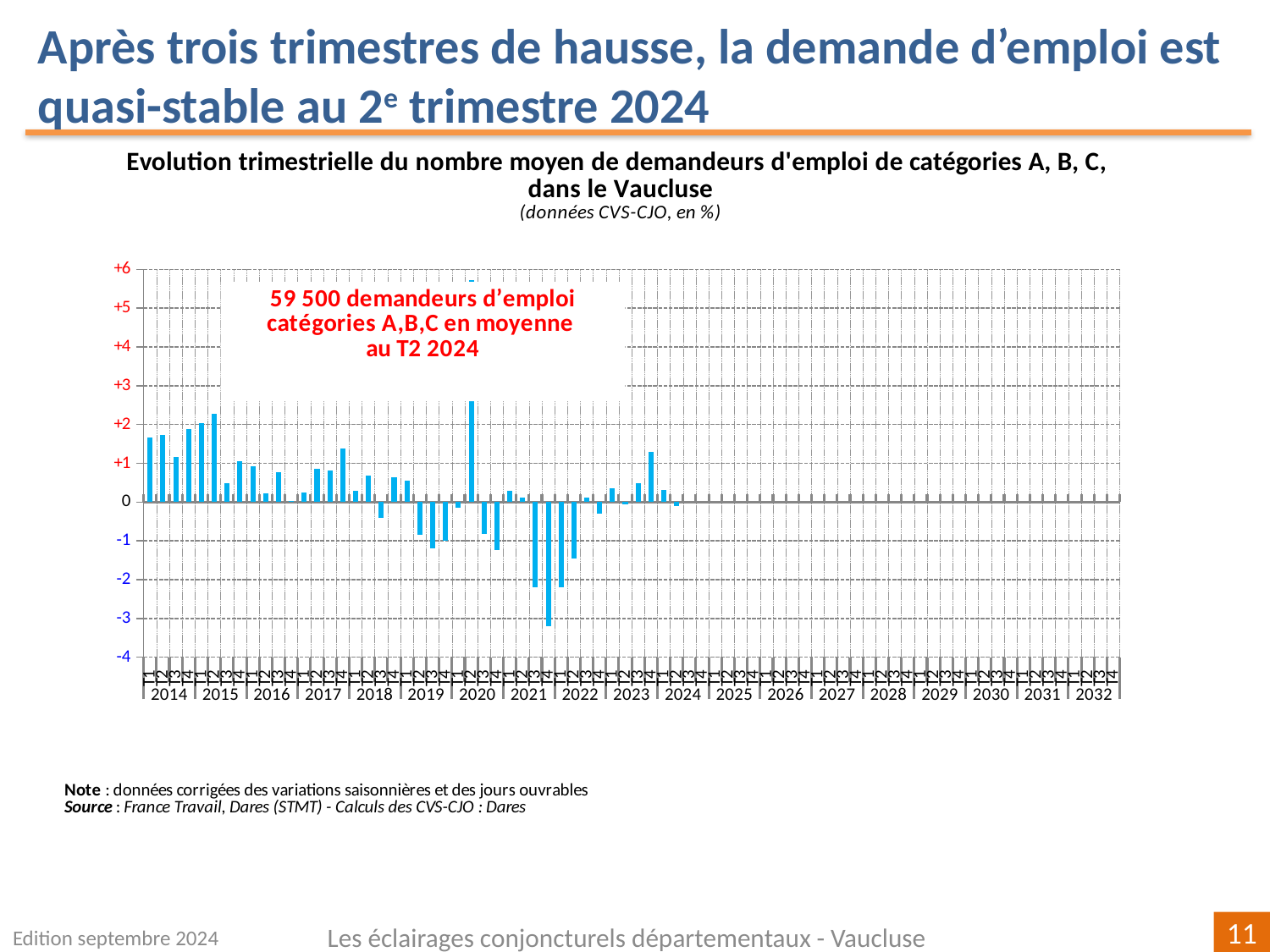
Is the value for Q2 2020 greater or less than +2? greater In what unit are the chart's data expressed, according to the subtitle? % In which quarter does the chart show its lowest value? Q4 2021 Which year contains the lowest bar on the chart? 2021 Is the value for Q2 2015 greater or less than +1? greater Is the value for Q3 2019 greater or less than 0? less Which is lower, the value for Q4 2021 or the value for Q2 2022? Q4 2021 Which is larger, the value for Q2 2015 or the value for Q3 2014? Q2 2015 According to the annotation on the chart, how many demandeurs d'emploi of categories A, B, C were there on average in T2 2024? 59 500 Do the values rise or fall from Q2 2021 to Q4 2021? fall What kind of chart is shown on the slide? bar chart